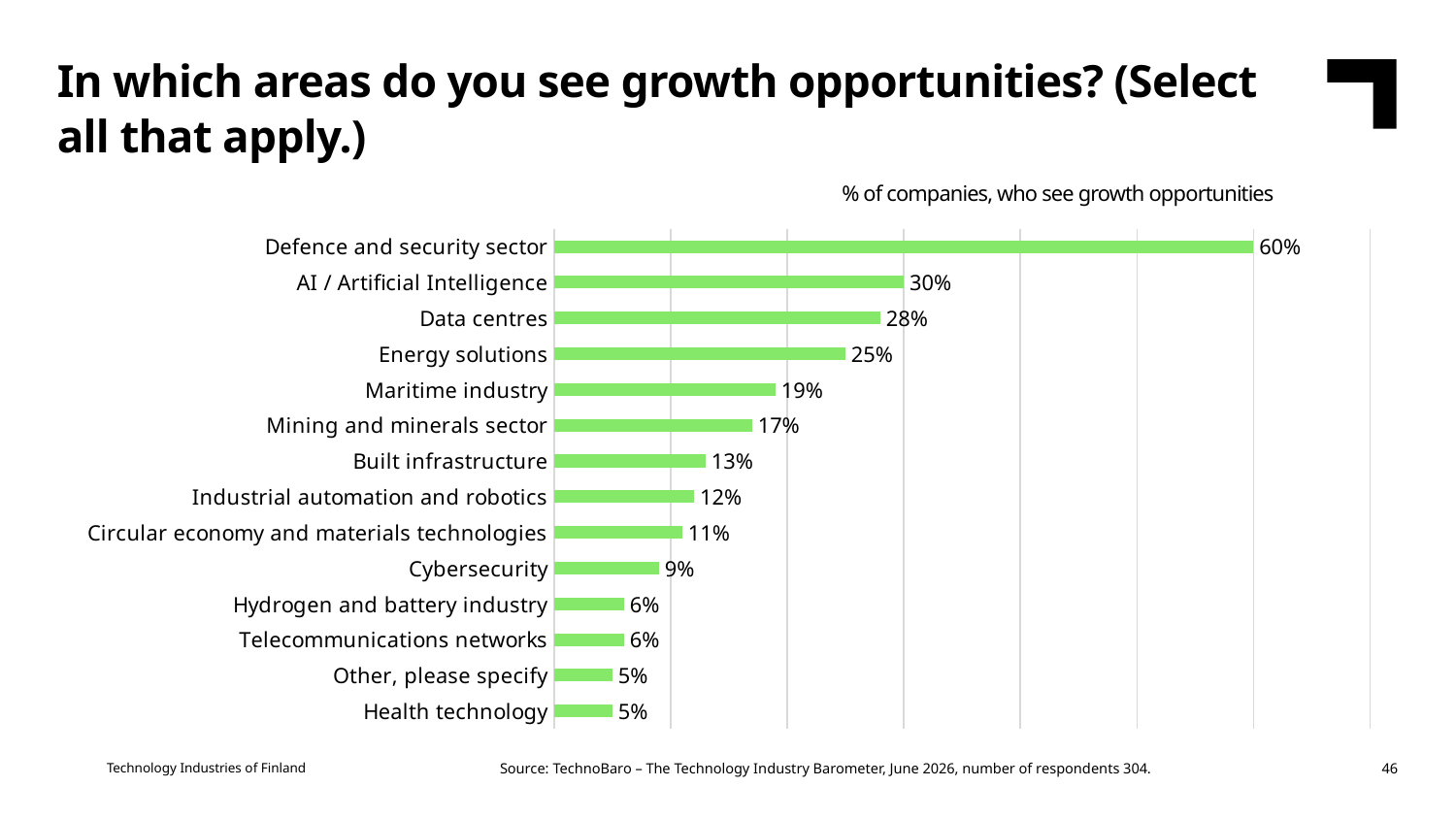
Which is larger, the value for Maritime industry or the value for Built infrastructure? Maritime industry What percentage of companies see growth opportunities in Cybersecurity? 9% What is the difference between the values for AI / Artificial Intelligence and Energy solutions? 5% How many areas (categories) are shown in the chart? 14 Which area has the highest share of companies seeing growth opportunities? Defence and security sector What is the value for Data centres? 28% What is the value for Circular economy and materials technologies? 11% What is the difference between the values for Defence and security sector and AI / Artificial Intelligence? 30% What is the subtitle shown above the chart? % of companies, who see growth opportunities What kind of chart is shown on the slide? Bar chart What percentage of companies see growth opportunities in the Defence and security sector? 60% Which is larger, the value for Mining and minerals sector or the value for Industrial automation and robotics? Mining and minerals sector